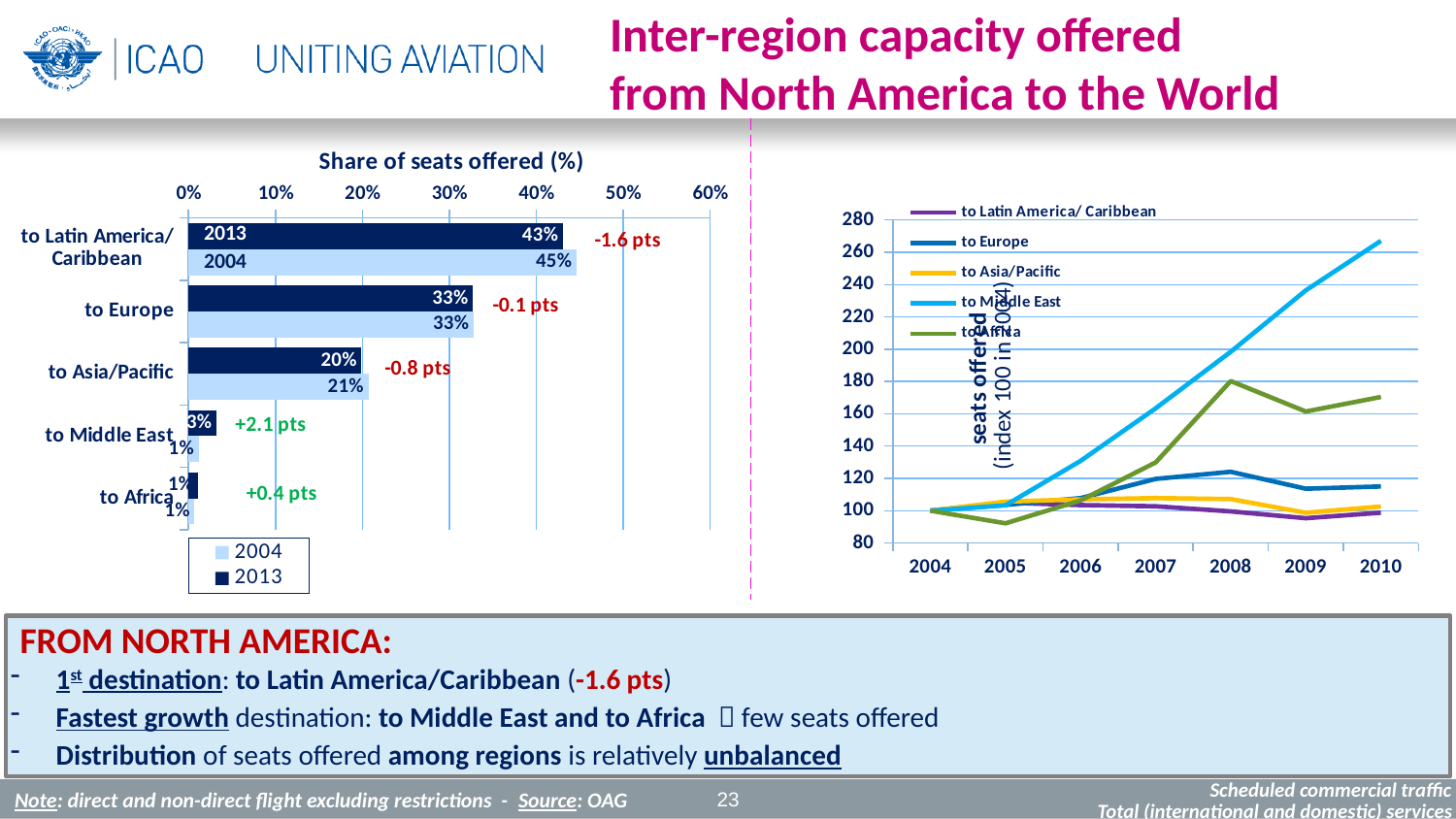
In the line chart on the right, which series has the highest value in 2010? to Middle East What type of chart is the chart on the left of the slide? bar chart In the 'Share of seats offered (%)' bar chart, what is the 2004 share for 'to Asia/Pacific'? 21% In the 'Share of seats offered (%)' bar chart, what is the 2013 share for 'to Latin America/ Caribbean'? 43% In the 'Share of seats offered (%)' bar chart, which destination has the highest 2013 share? to Latin America/ Caribbean In the 'Share of seats offered (%)' bar chart, what is the difference between the 2004 and 2013 shares for 'to Latin America/ Caribbean' as labelled on the chart? -1.6 pts In the 'Share of seats offered (%)' bar chart, what is the 2013 share for 'to Middle East'? 3% In the 'Share of seats offered (%)' bar chart, which destination has the lowest 2013 share? to Africa How many series does the legend of the line chart on the right list? 5 In the 'Share of seats offered (%)' bar chart, is the 2013 share for 'to Europe' larger or smaller than the 2013 share for 'to Asia/Pacific'? larger How many series does the legend of the 'Share of seats offered (%)' bar chart list? 2 In the line chart on the right, is the 2010 value for 'to Middle East' greater or less than 240? greater